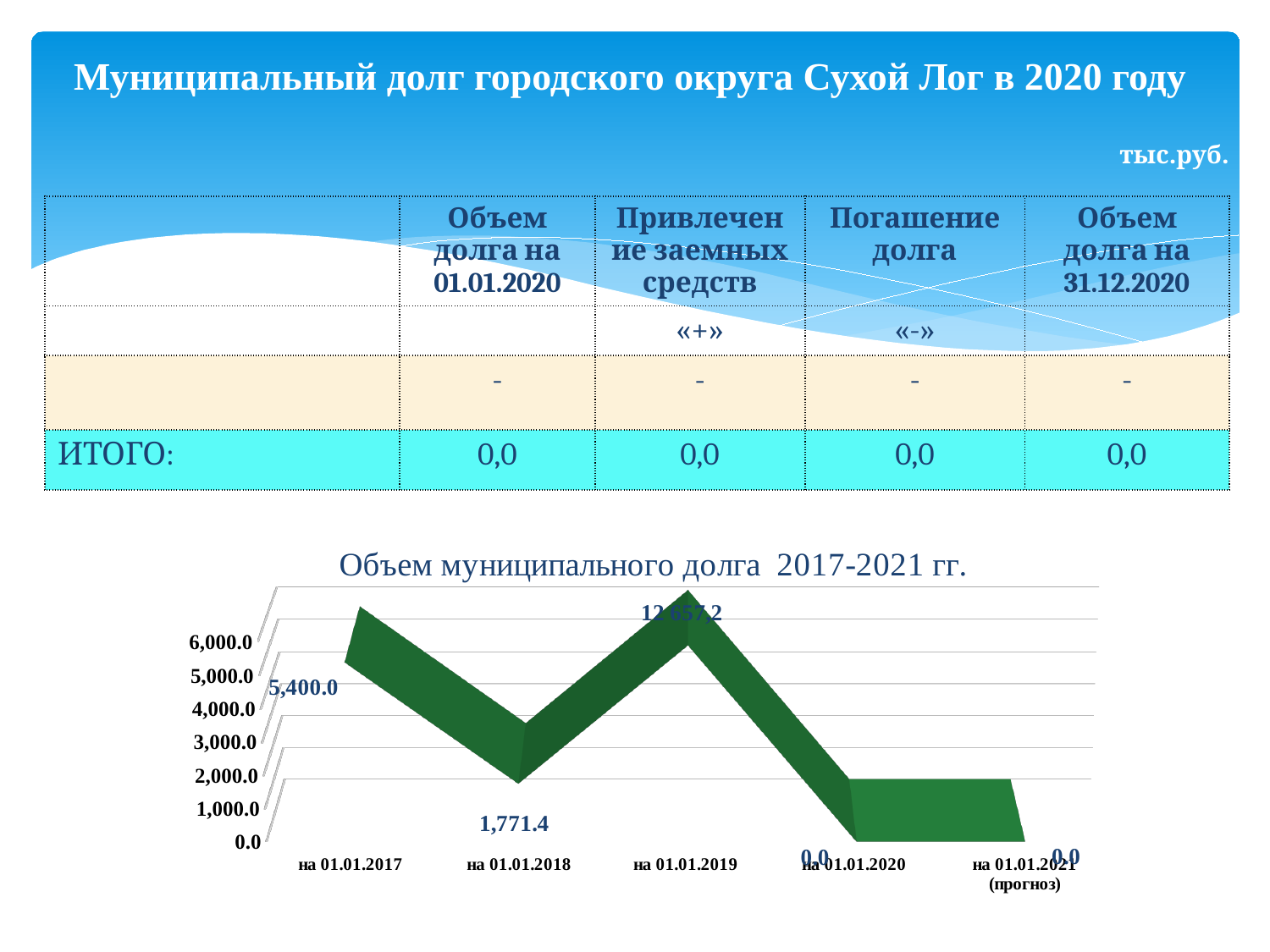
What is the value for на 01.01.2017? 5,400.0 Which is larger, the value for на 01.01.2017 or the value for на 01.01.2018? на 01.01.2017 What kind of chart is shown on the slide? line chart What is the value for на 01.01.2020? 0.0 What is the value for на 01.01.2018? 1,771.4 Which date has the highest value on the chart? на 01.01.2019 What is the difference between the values for на 01.01.2017 and на 01.01.2018? 3,628.6 Do the values rise or fall from на 01.01.2019 to на 01.01.2021 (прогноз)? fall How many data points are plotted on the chart? 5 What is the value for на 01.01.2021 (прогноз)? 0.0 What is the title of the chart? Объем муниципального долга 2017-2021 гг.